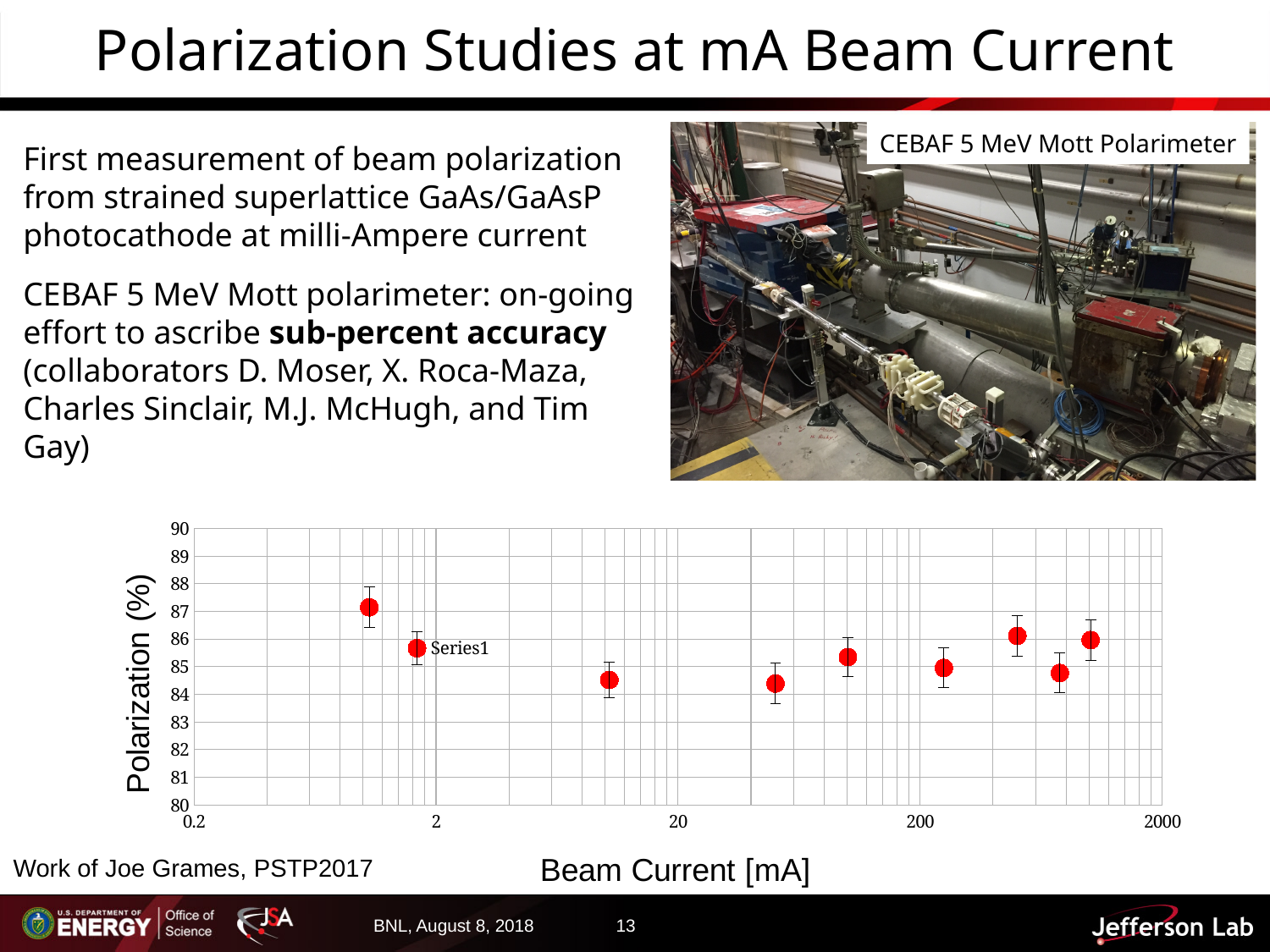
What is the name of the series shown in the chart? Series1 What kind of chart is shown at the bottom of the slide? scatter chart Which data point has the highest polarization: the leftmost point or the rightmost point? the leftmost point Is the polarization value for the data point near 40 mA greater or less than 86? less Between the first and second data points from the left, does the polarization rise or fall? fall Is the polarization value for the rightmost data point (highest beam current) greater or less than 85? greater How many data points are plotted in the chart? 9 What is the label of the y axis of the chart? Polarization (%) What is the highest value shown on the x axis of the chart? 2000 How many series does the chart show? 1 Which data point has the highest polarization in the chart? the leftmost point (lowest beam current) Is the polarization value for the leftmost data point (lowest beam current) greater or less than 86? greater